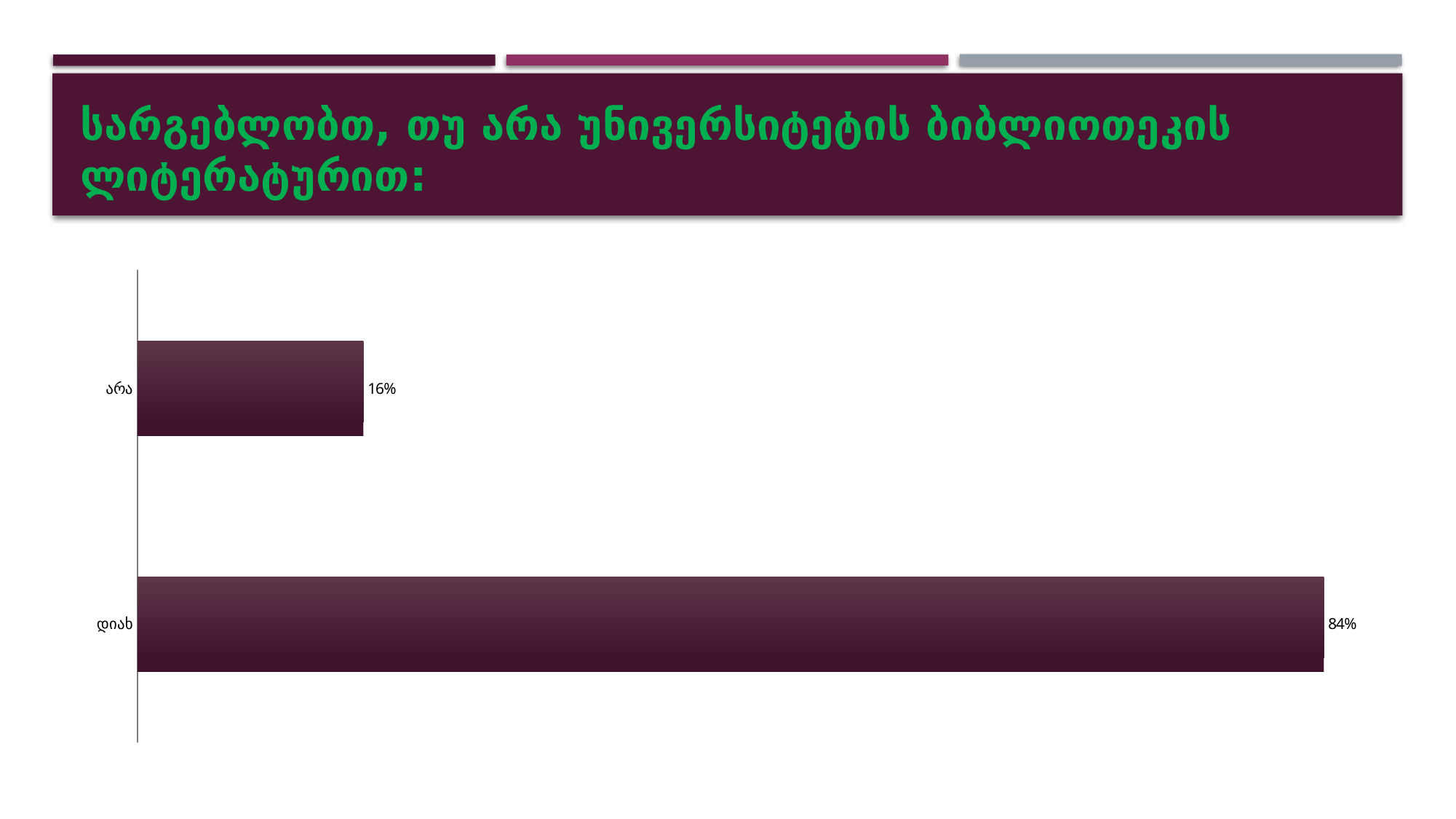
Are the bars in the chart horizontal or vertical? Horizontal What is the value for დიახ? 84% How many categories are shown in the chart? 2 What is the total of the values for დიახ and არა? 100% Which category has the lowest value? არა What kind of chart is shown on the slide? Bar chart What is the difference between the values for დიახ and არა? 68% What is the title of the slide? სარგებლობთ, თუ არა უნივერსიტეტის ბიბლიოთეკის ლიტერატურით: What is the value for არა? 16% Which is larger, the value for დიახ or the value for არა? დიახ Which category has the highest value? დიახ